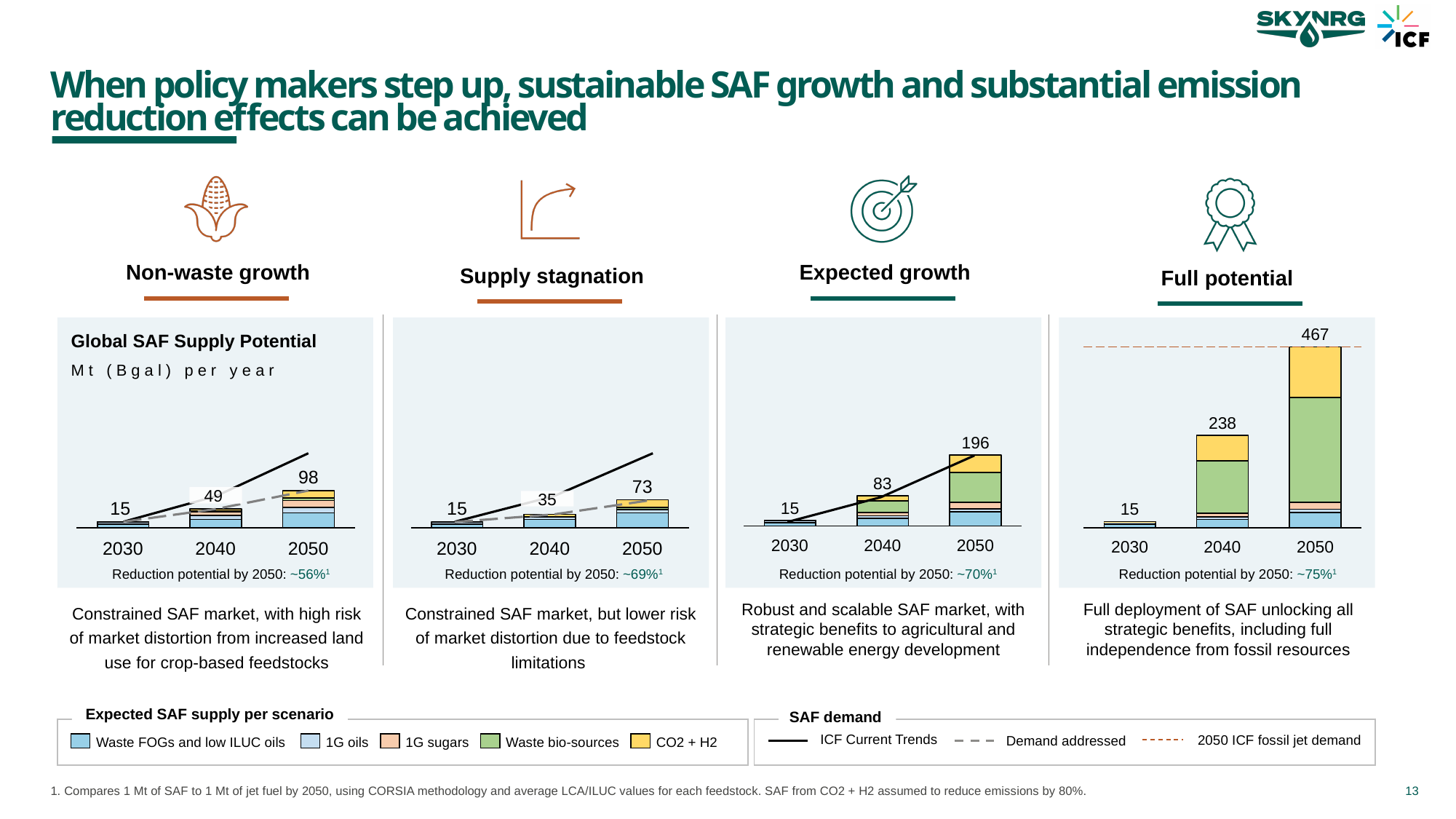
How many feedstock series does the 'Expected SAF supply per scenario' legend list? 5 In the Expected growth chart, what is the difference between the 2050 and 2040 totals? 113 Which legend entry is shown in yellow in the 'Expected SAF supply per scenario' legend? CO2 + H2 In the Full potential chart, what is the value labelled for 2040? 238 In the Expected growth chart, what is the value labelled for 2050? 196 What kind of chart is used in the Full potential panel? Stacked bar chart Which is larger: the 2050 total in the Supply stagnation chart or the 2050 total in the Non-waste growth chart? Non-waste growth (98) How many years are shown on the x axis of the Supply stagnation chart? 3 In the Supply stagnation chart, what is the value labelled for 2040? 35 In the Full potential chart, which year has the highest total? 2050 In the Expected growth chart, do the totals rise or fall from 2030 to 2050? Rise In the Non-waste growth chart, what is the total SAF supply potential shown for 2050? 98